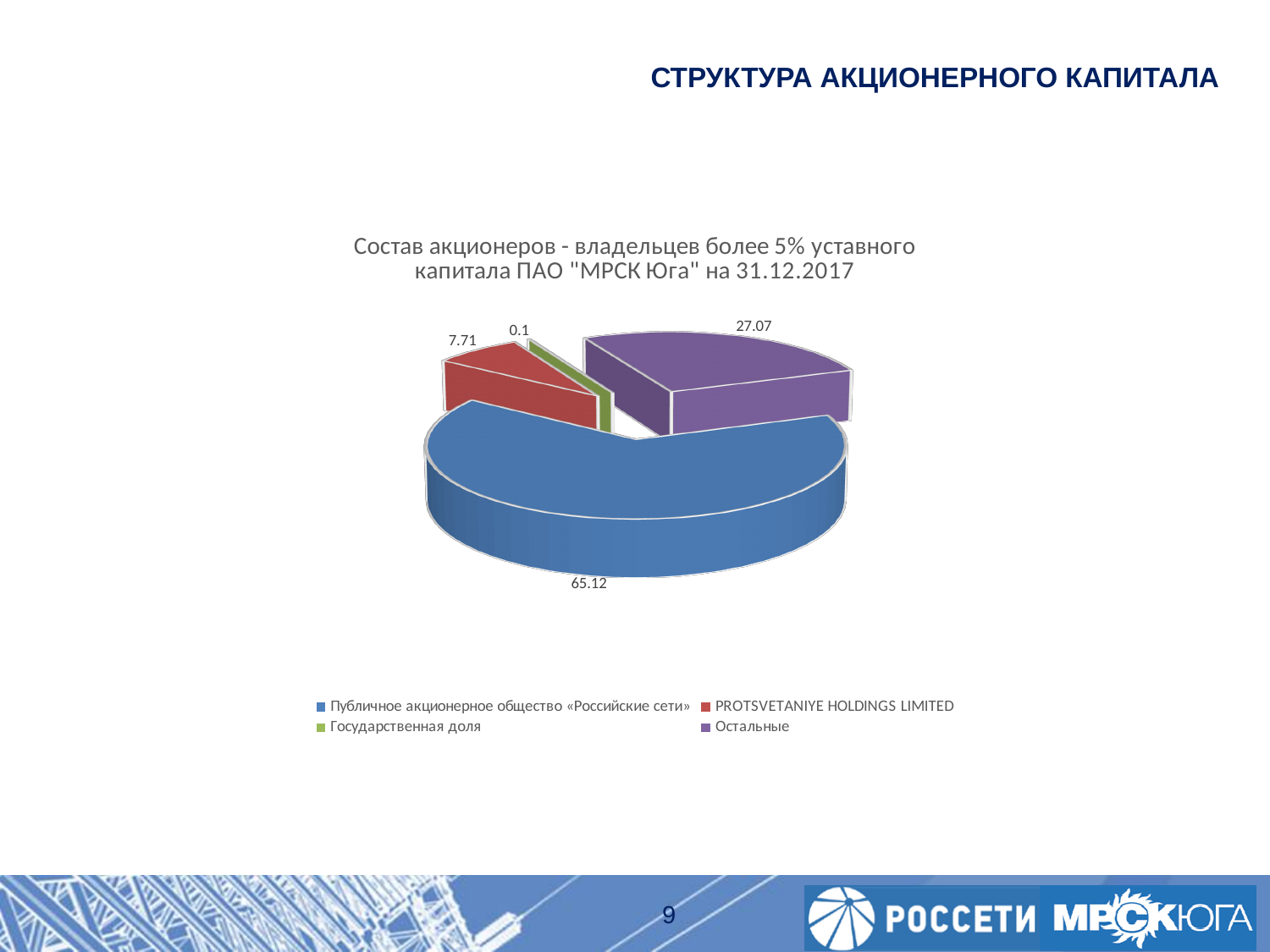
Which category has the largest slice? Публичное акционерное общество «Российские сети» What colour is the slice for Остальные? purple How many slices does the pie chart have? 4 Which is larger, the value for Остальные or the value for PROTSVETANIYE HOLDINGS LIMITED? Остальные What is the difference between the values for Остальные and PROTSVETANIYE HOLDINGS LIMITED? 19.36 What kind of chart is shown on the slide? pie chart How many entries does the legend list? 4 Which category has the smallest slice? Государственная доля What is the value for Остальные? 27.07 What is the value for Государственная доля? 0.1 What is the value for PROTSVETANIYE HOLDINGS LIMITED? 7.71 What is the value for Публичное акционерное общество «Российские сети»? 65.12